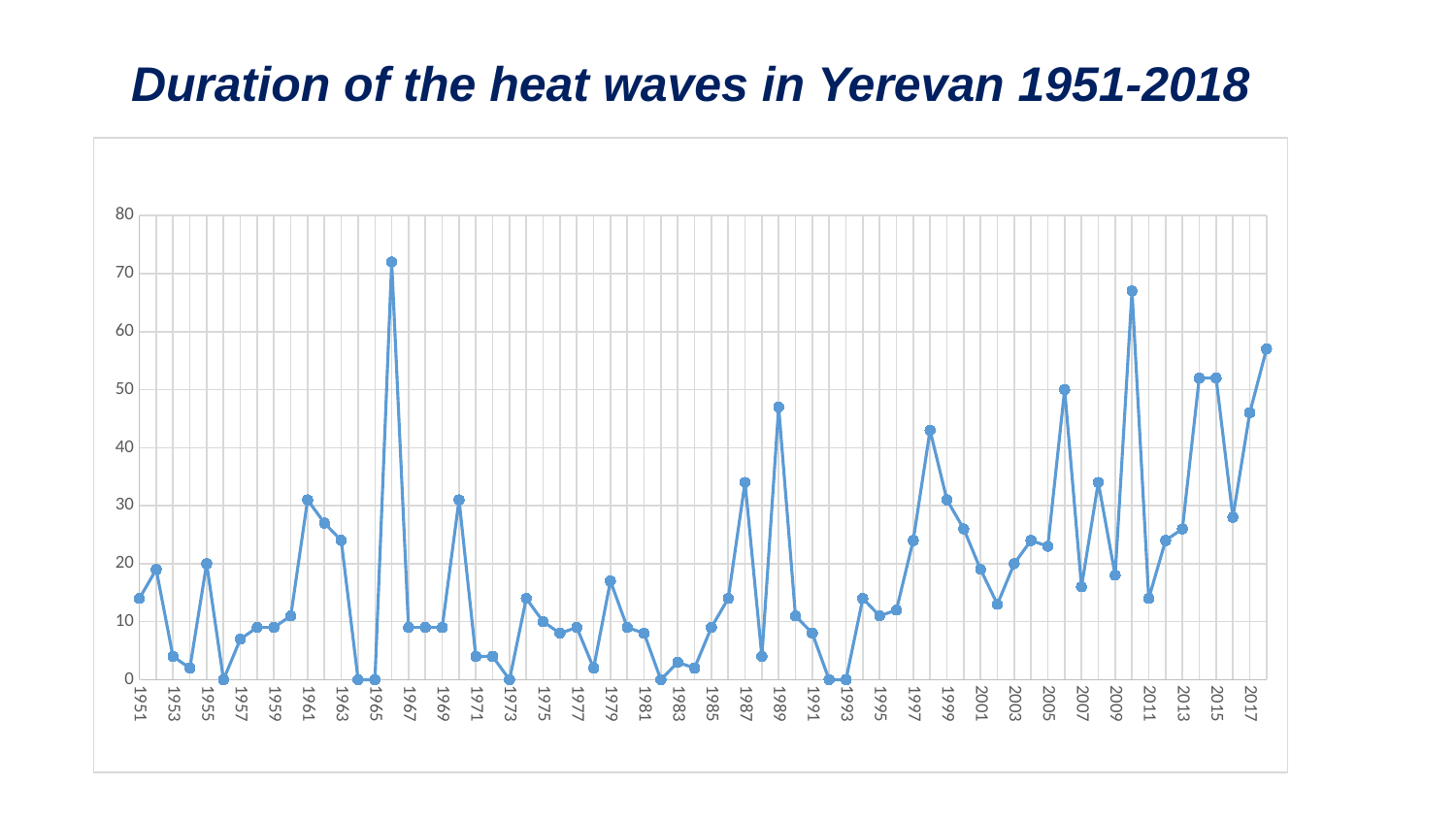
Which year has the larger value, 2018 or 1989? 2018 Is the value for 1989 greater or less than 40? greater Is the value for 1966 greater or less than 70? greater In which year is the duration of the heat waves highest? 1966 Is the value for 2010 greater or less than 60? greater What is the title of the chart? Duration of the heat waves in Yerevan 1951-2018 Do the values generally rise or fall from 1951 to 2018? rise What kind of chart is shown on the slide? line chart Which year has the larger value, 1966 or 2010? 1966